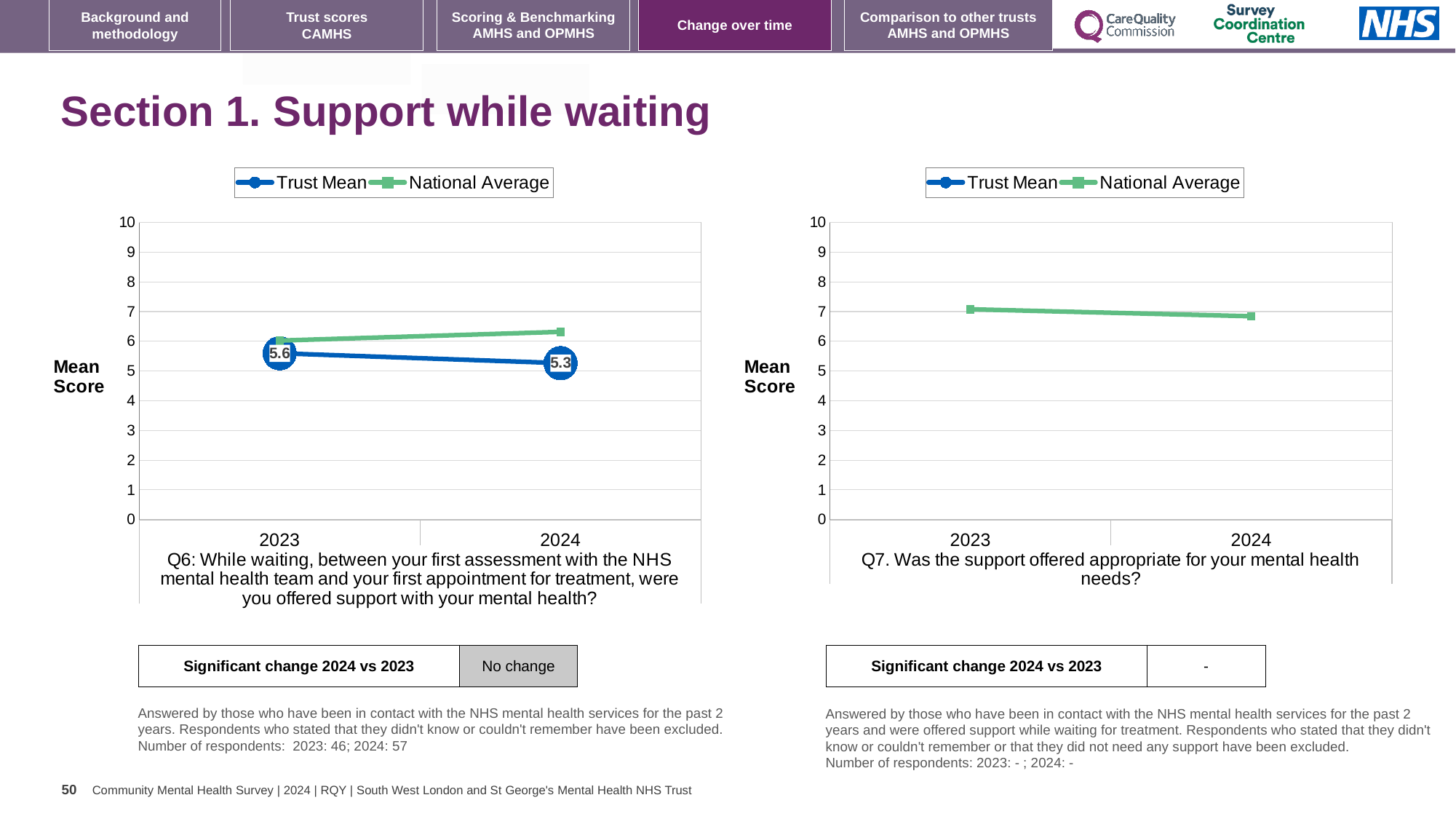
On the left chart (Q6), does the National Average rise or fall from 2023 to 2024? rise On the left chart (Q6), is the National Average for 2024 greater or less than 6? greater On the left chart (Q6), by how much did the Trust Mean change from 2023 to 2024? 0.3 What type of chart is the left chart (Q6)? line chart On the left chart (Q6), does the Trust Mean rise or fall from 2023 to 2024? fall On the left chart (Q6), in 2024 which is higher, the Trust Mean or the National Average? National Average How many years are shown on the x axis of the right chart (Q7)? 2 On the left chart (Q6), what is the Trust Mean score for 2023? 5.6 On the left chart (Q6), what is the Trust Mean score for 2024? 5.3 How many series does the legend of the left chart (Q6) list? 2 On the right chart (Q7), does the National Average rise or fall from 2023 to 2024? fall